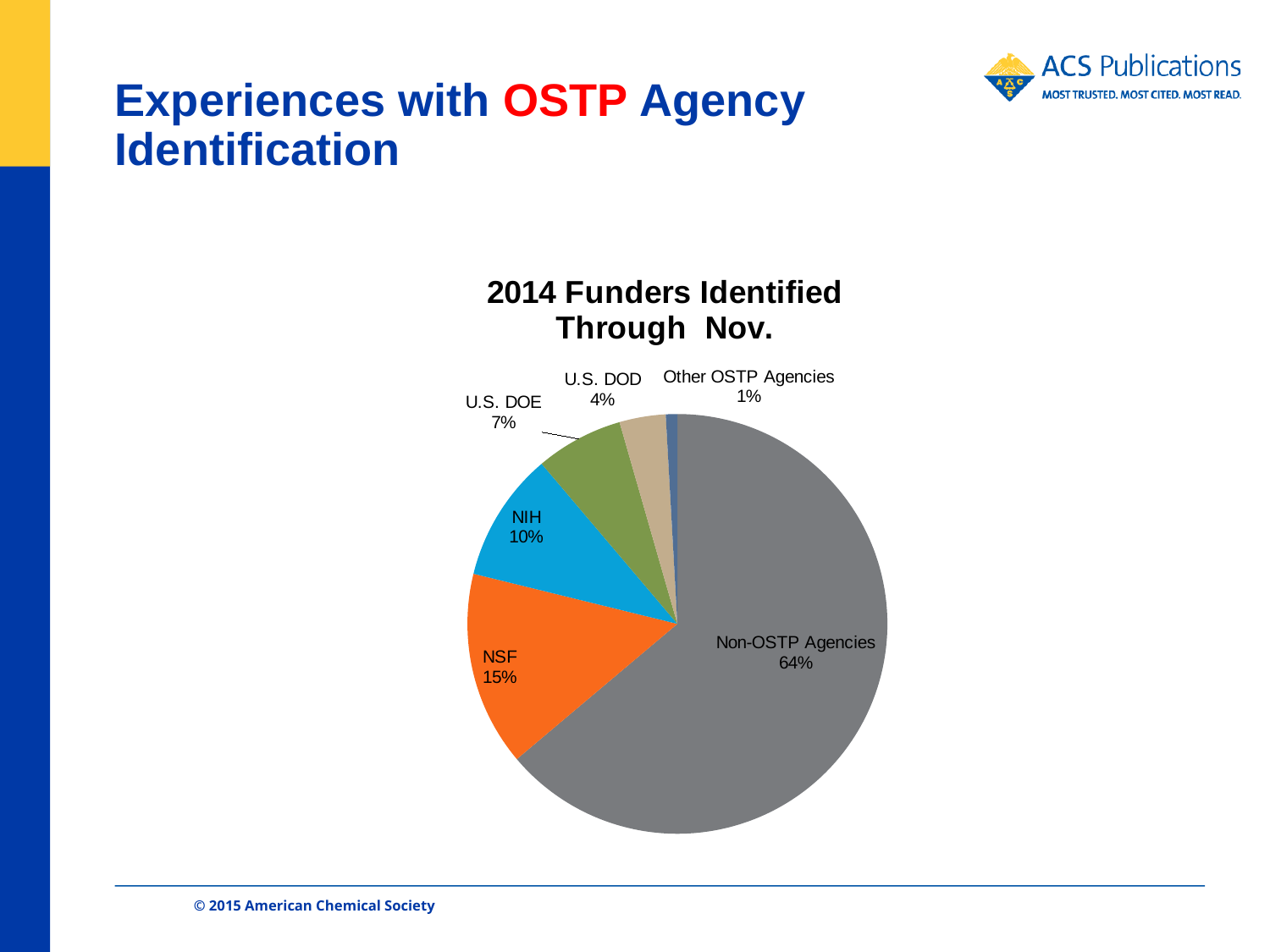
What is the difference in percentage points between NSF and NIH? 5 What percentage is shown for U.S. DOE? 7% Which category has the smallest slice of the pie? Other OSTP Agencies What percentage is shown for Other OSTP Agencies? 1% Which category has the largest slice of the pie? Non-OSTP Agencies How many slices does the pie chart have? 6 What percentage is shown for NSF? 15% What kind of chart is shown on the slide? pie chart What percentage is shown for NIH? 10% What percentage is shown for U.S. DOD? 4% What share of the pie is Non-OSTP Agencies? 64% What is the title of the chart? 2014 Funders Identified Through Nov.